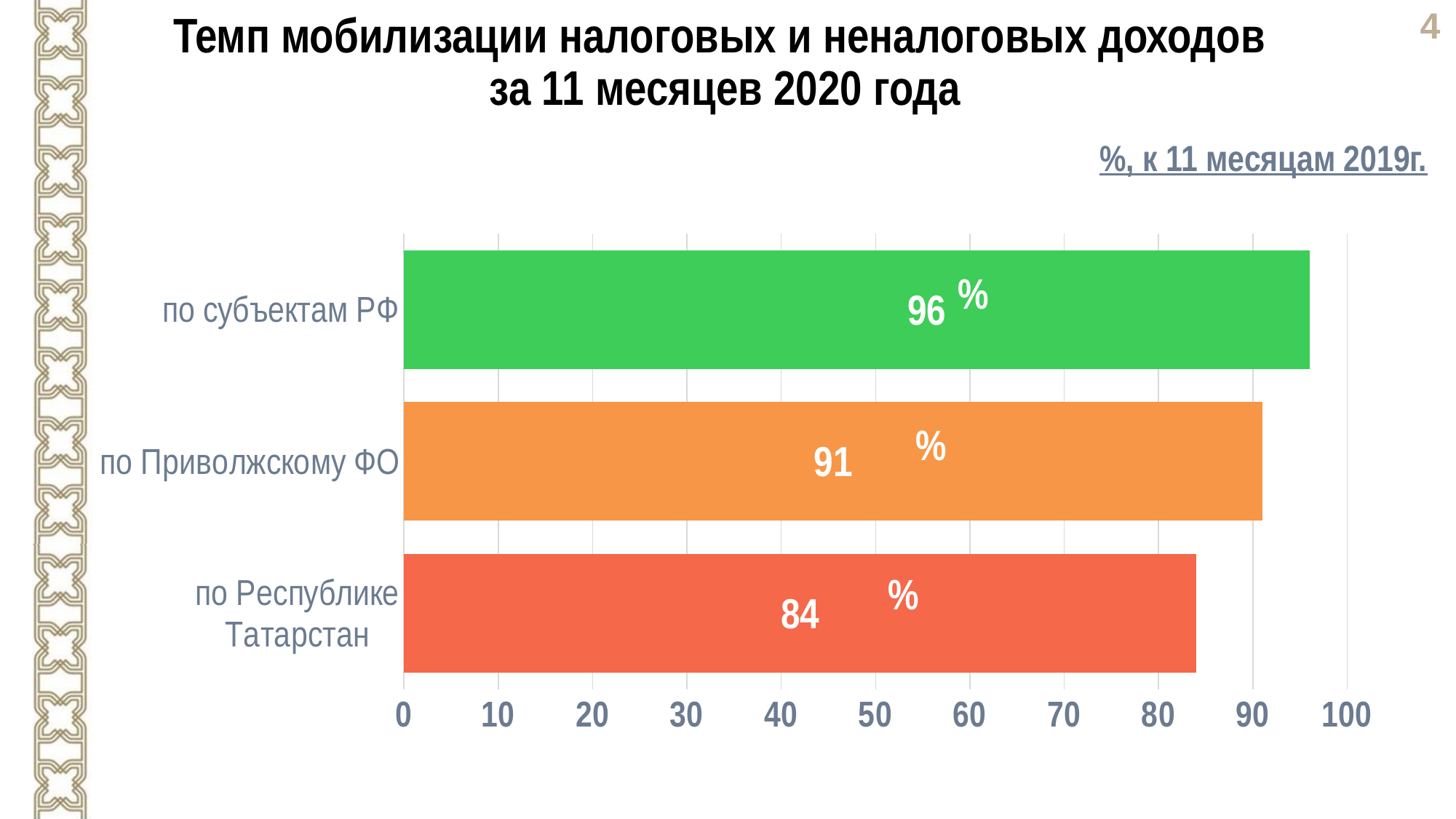
What kind of chart is shown on the slide? bar chart What is the value for «по Приволжскому ФО»? 91 % How many categories are shown in the chart? 3 What is the value for «по субъектам РФ»? 96 % What is the difference between the values for «по субъектам РФ» and «по Республике Татарстан»? 12 What is the difference between the values for «по Приволжскому ФО» and «по Республике Татарстан»? 7 Which category has the lowest value? по Республике Татарстан Which category has the highest value? по субъектам РФ What is the value for «по Республике Татарстан»? 84 % Is the value for «по Республике Татарстан» greater or less than 90? less Which is larger, the value for «по Приволжскому ФО» or for «по Республике Татарстан»? по Приволжскому ФО What is the title of the chart? Темп мобилизации налоговых и неналоговых доходов за 11 месяцев 2020 года